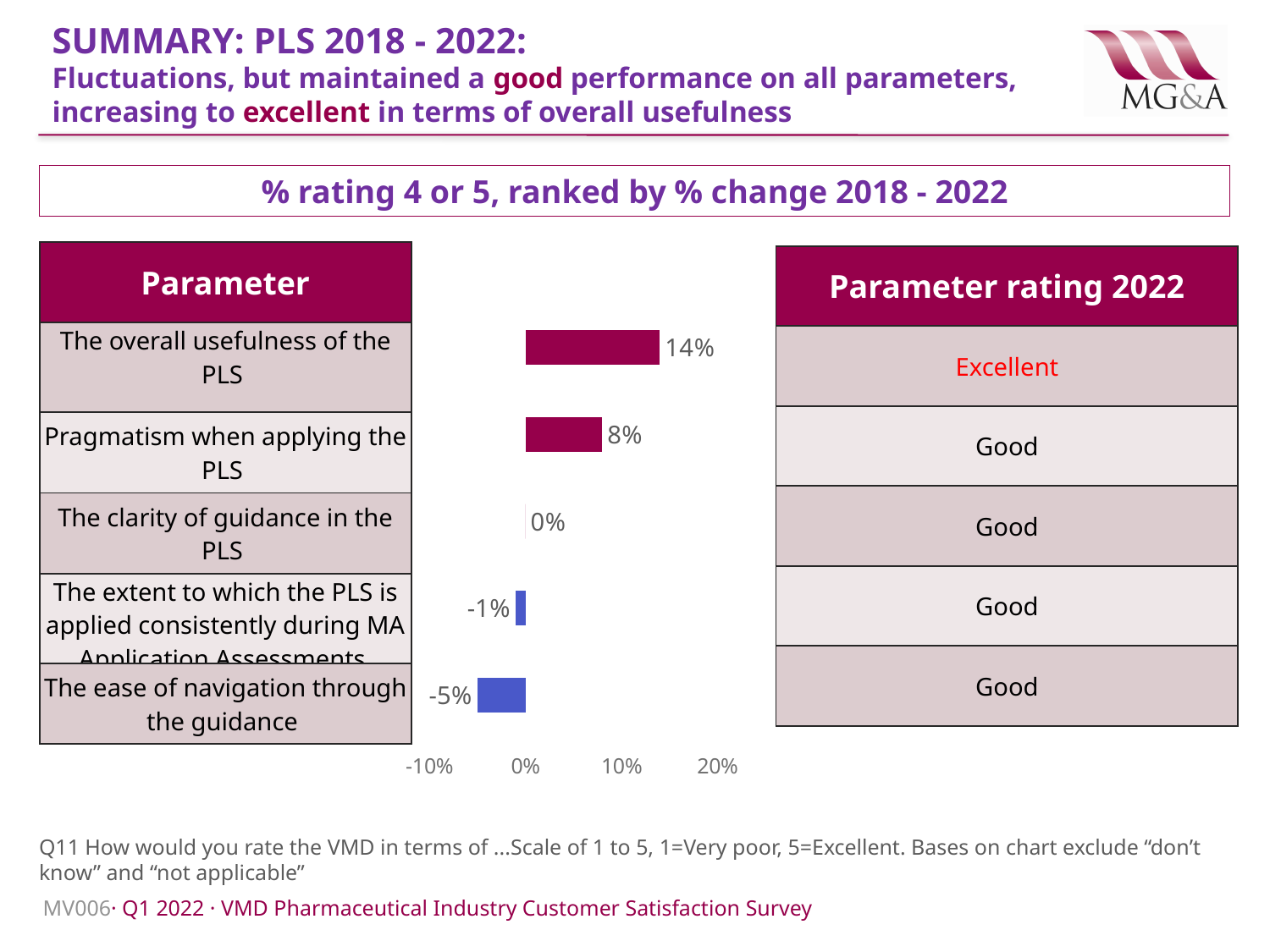
What is the % change 2018 - 2022 for 'Pragmatism when applying the PLS'? 8% What is the % change 2018 - 2022 for 'The ease of navigation through the guidance'? -5% What kind of chart is shown on the slide? Bar chart What is the difference between the % change for 'The overall usefulness of the PLS' and 'Pragmatism when applying the PLS'? 6% What is the % change 2018 - 2022 for 'The overall usefulness of the PLS'? 14% Which has a larger % change 2018 - 2022: 'Pragmatism when applying the PLS' or 'The ease of navigation through the guidance'? Pragmatism when applying the PLS What is the % change 2018 - 2022 for 'The clarity of guidance in the PLS'? 0% What is the Parameter rating 2022 for 'The overall usefulness of the PLS'? Excellent How many parameters are plotted in the chart? 5 Which parameter has the lowest % change 2018 - 2022? The ease of navigation through the guidance Which parameter has the highest % change 2018 - 2022? The overall usefulness of the PLS What is the title of the chart? % rating 4 or 5, ranked by % change 2018 - 2022